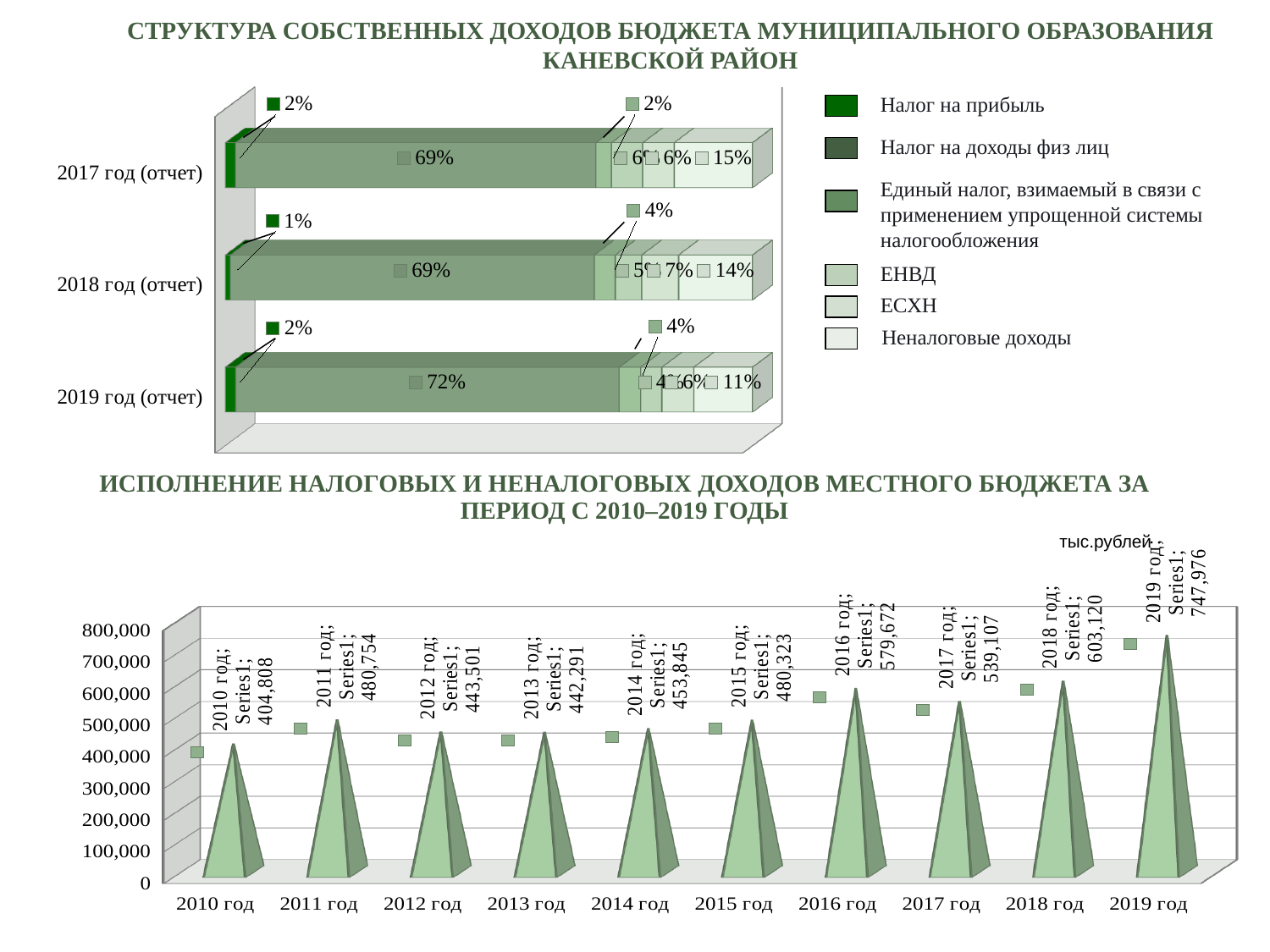
In the top chart (СТРУКТУРА СОБСТВЕННЫХ ДОХОДОВ), what share does Налог на доходы физ лиц have in 2019 год (отчет)? 72% In the bottom chart (ИСПОЛНЕНИЕ НАЛОГОВЫХ И НЕНАЛОГОВЫХ ДОХОДОВ), how many years are shown on the x axis? 10 In the top chart (СТРУКТУРА СОБСТВЕННЫХ ДОХОДОВ), what share do Неналоговые доходы have in 2017 год (отчет)? 15% In the bottom chart (ИСПОЛНЕНИЕ НАЛОГОВЫХ И НЕНАЛОГОВЫХ ДОХОДОВ), what is the value for 2019 год? 747,976 In the bottom chart (ИСПОЛНЕНИЕ НАЛОГОВЫХ И НЕНАЛОГОВЫХ ДОХОДОВ), which is larger: the value for 2016 год or 2017 год? 2016 год What kind of chart is the top chart (СТРУКТУРА СОБСТВЕННЫХ ДОХОДОВ)? stacked bar chart In the bottom chart (ИСПОЛНЕНИЕ НАЛОГОВЫХ И НЕНАЛОГОВЫХ ДОХОДОВ), which year has the lowest value? 2010 год In the bottom chart (ИСПОЛНЕНИЕ НАЛОГОВЫХ И НЕНАЛОГОВЫХ ДОХОДОВ), do the values rise or fall from 2017 год to 2019 год? rise In the bottom chart (ИСПОЛНЕНИЕ НАЛОГОВЫХ И НЕНАЛОГОВЫХ ДОХОДОВ), which year has the highest value? 2019 год In the bottom chart (ИСПОЛНЕНИЕ НАЛОГОВЫХ И НЕНАЛОГОВЫХ ДОХОДОВ), what is the difference between the values for 2019 год and 2018 год? 144,856 In the bottom chart (ИСПОЛНЕНИЕ НАЛОГОВЫХ И НЕНАЛОГОВЫХ ДОХОДОВ), what is the value for 2010 год? 404,808 In the top chart (СТРУКТУРА СОБСТВЕННЫХ ДОХОДОВ), how many series does the legend list? 6